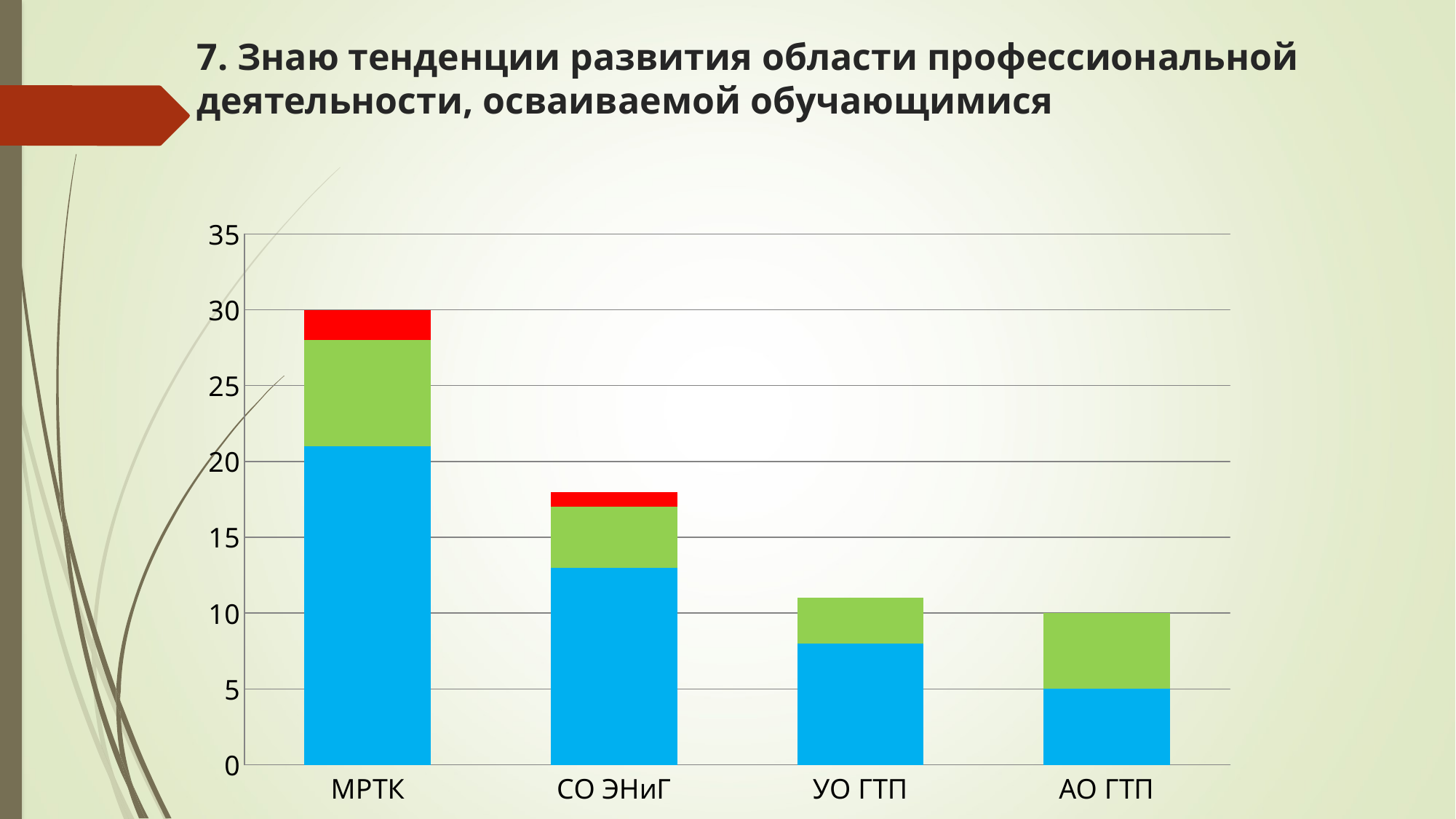
Is the total value for СО ЭНиГ greater or less than 20? less What is the total height of the stacked bar for АО ГТП? 10 What is the difference between the total for МРТК and the total for АО ГТП? 20 Which category has the tallest stacked bar? МРТК Which has a taller stacked bar, МРТК or СО ЭНиГ? МРТК Is the total value for СО ЭНиГ greater or less than 15? greater What kind of chart is shown on the slide? bar chart What is the value of the blue (bottom) segment for АО ГТП? 5 Do the total bar heights rise or fall from left to right along the x axis? fall How many categories are shown on the x axis? 4 What is the total height of the stacked bar for МРТК? 30 Which category has the shortest stacked bar? АО ГТП